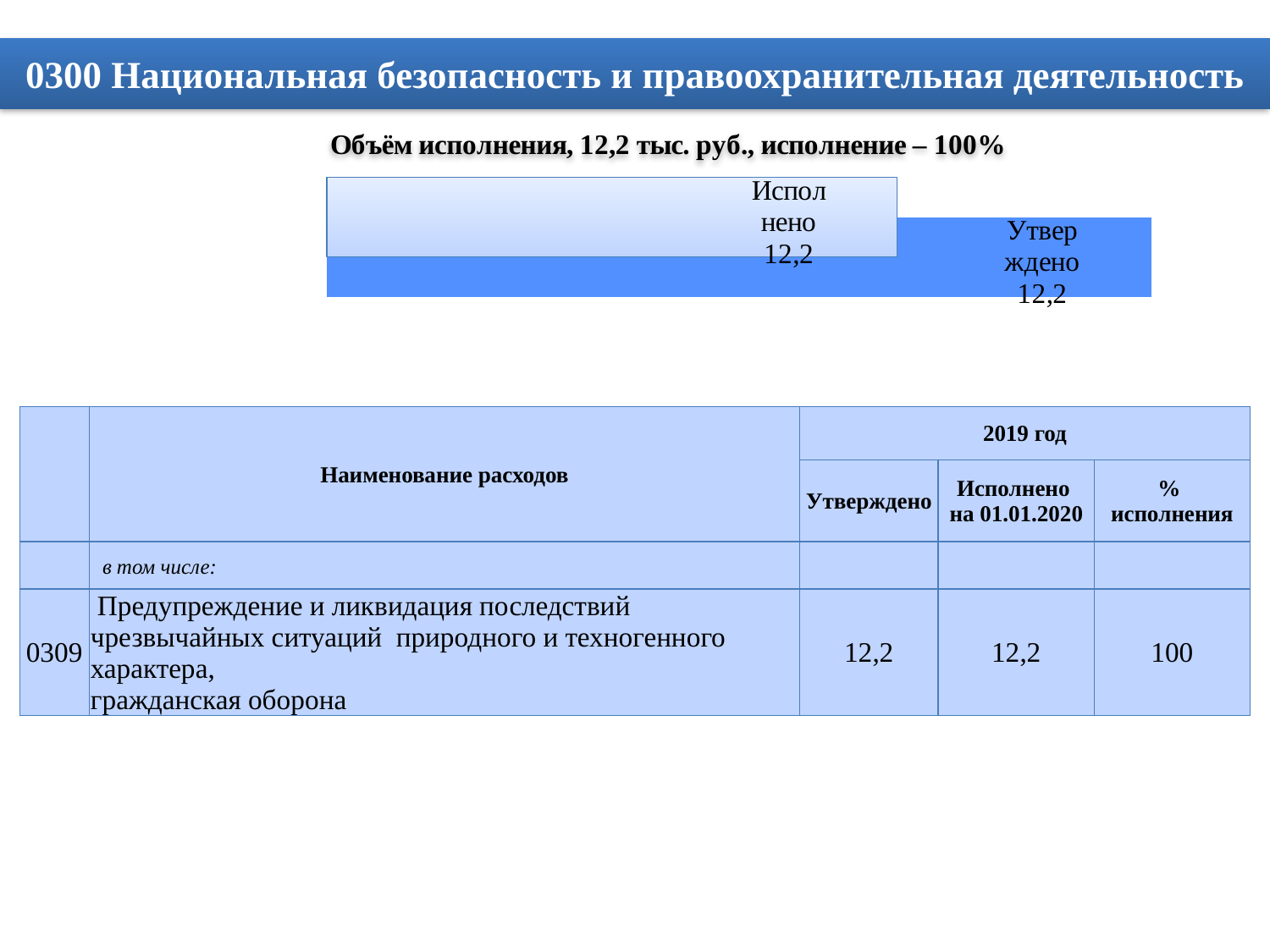
What is the value of the Исполнено bar? 12,2 Which bar in the chart is drawn in the lighter blue colour? Исполнено What is the title shown above the chart? Объём исполнения, 12,2 тыс. руб., исполнение – 100% What is the value of the Утверждено bar? 12,2 Are the Утверждено and Исполнено values in the chart equal? yes What is the difference between the Утверждено and Исполнено values in the chart? 0 How many bars does the chart show? 2 What kind of chart is shown on the slide? bar chart